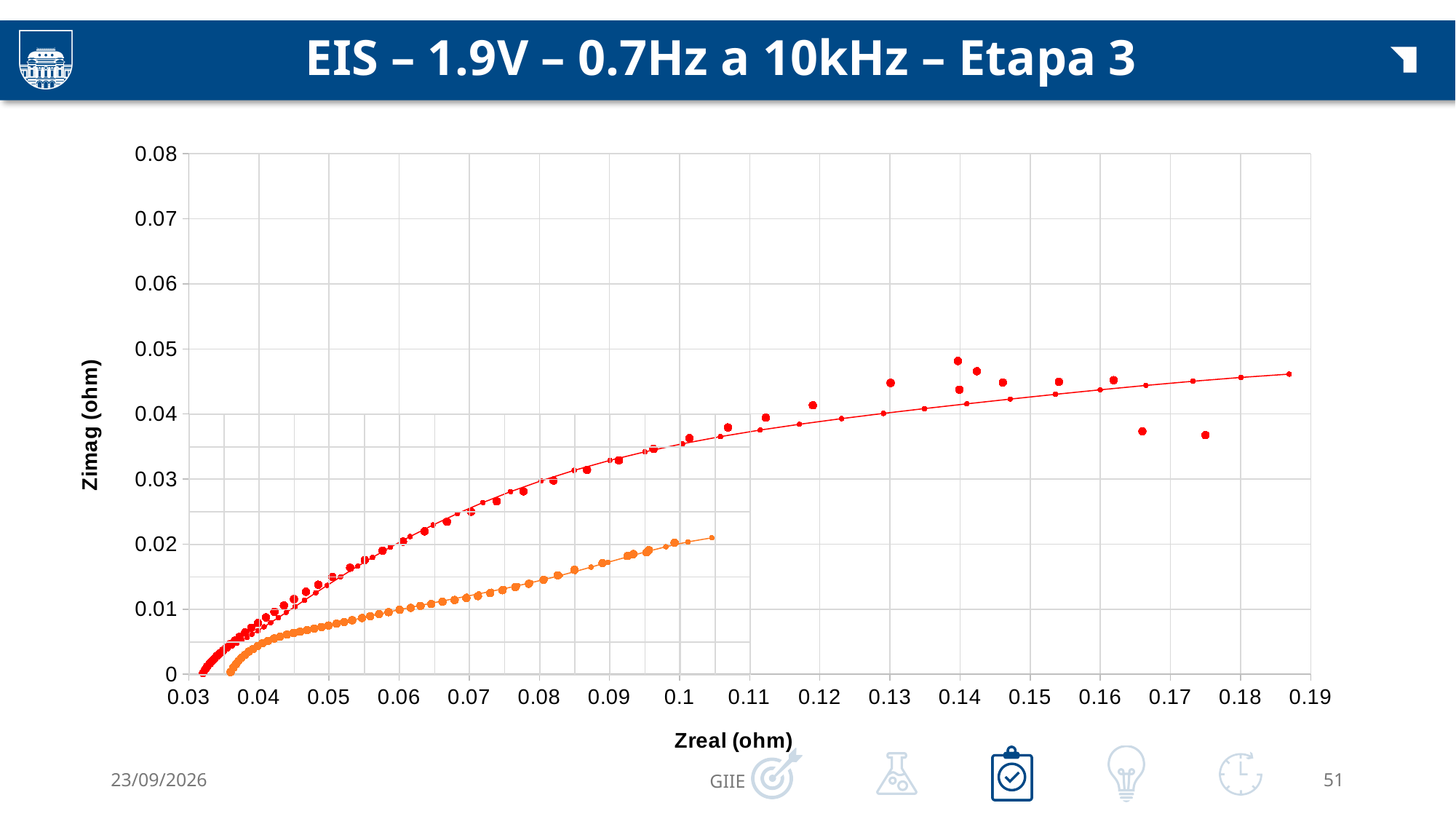
What is the label of the horizontal axis? Zreal (ohm) Is the highest Zimag value of the red series greater or less than 0.04? greater At Zreal = 0.08, which series has the higher Zimag value, the red or the orange? Red Is the largest Zreal value reached by the orange series greater or less than 0.11? less Is the highest Zimag value of the orange series greater or less than 0.03? less Does Zimag rise or fall as Zreal increases along the red series? Rise What kind of chart is shown on the slide? Scatter chart Does Zimag rise or fall as Zreal increases along the orange series? Rise What is the label of the vertical axis? Zimag (ohm) What is the title of the chart on the slide? EIS – 1.9V – 0.7Hz a 10kHz – Etapa 3